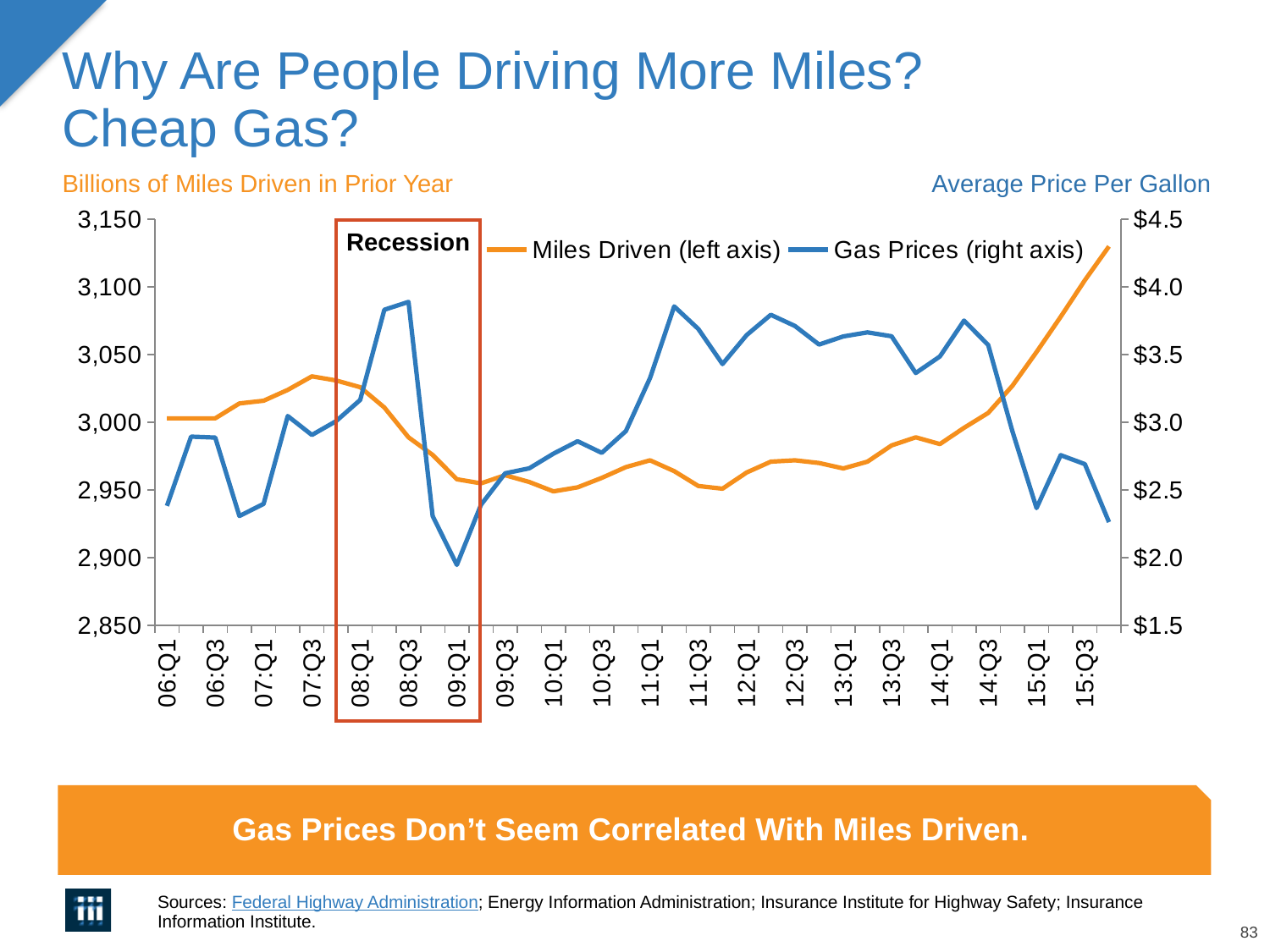
Is the Miles Driven value at 15:Q3 greater or less than 3,050? greater Is the Miles Driven value at 10:Q1 greater or less than 3,000? less Is the Gas Prices value at 06:Q1 greater or less than $3.0? less How many series does the chart legend list? 2 What colour is the Miles Driven line? Orange What kind of chart is shown on the slide? Line chart At which quarter does the Gas Prices line reach its lowest point? 09:Q1 Which series is plotted against the right axis? Gas Prices Which is higher, the Gas Prices value at 08:Q3 or at 09:Q1? 08:Q3 Does the Miles Driven line rise or fall between 14:Q1 and 15:Q3? Rise